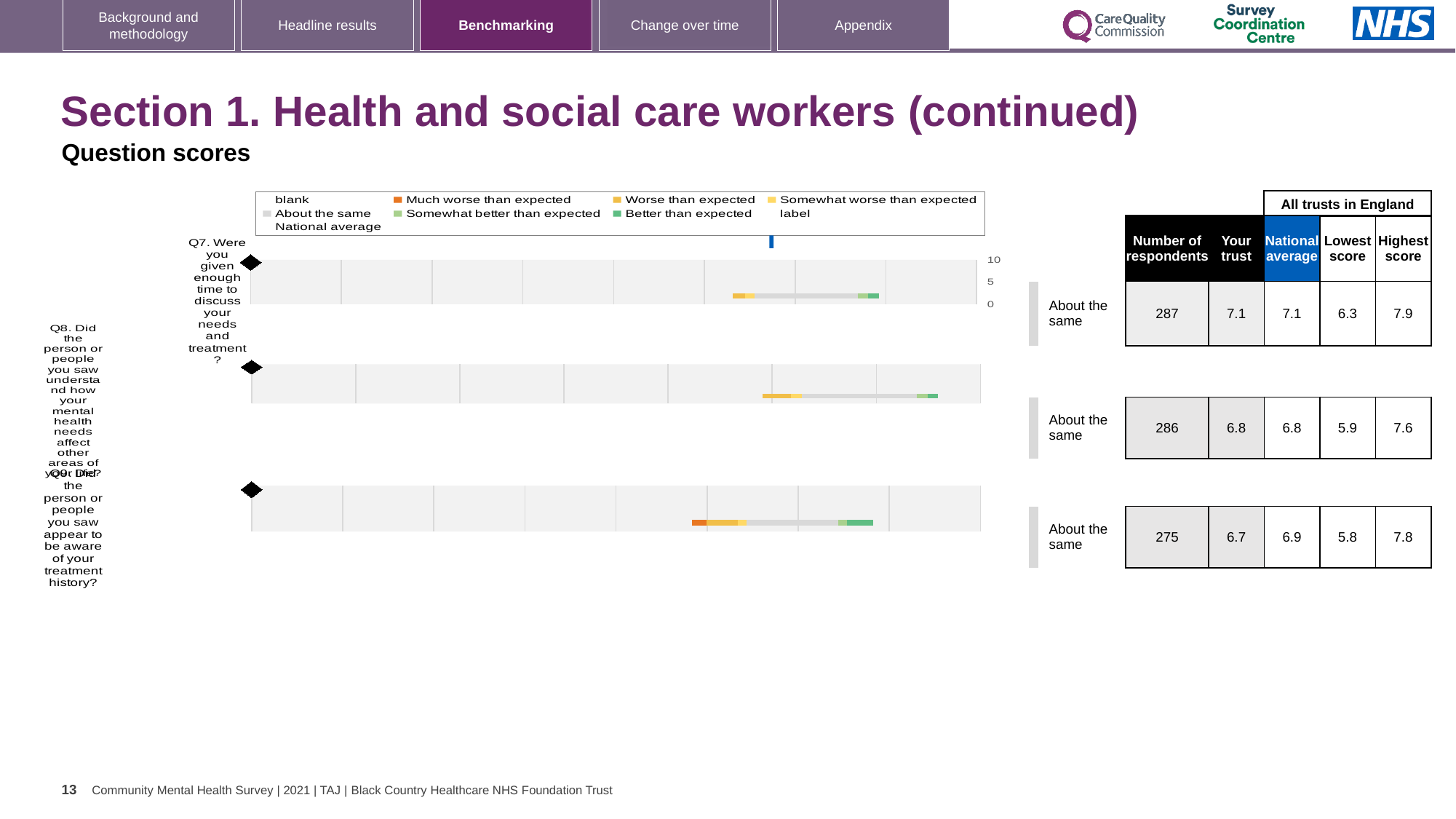
In the table next to the Q9 chart, what is the national average score? 6.9 How many entries does the shared legend above the charts list? 9 In the table next to the Q7 chart, what is the 'Your trust' score? 7.1 What is the highest value shown on the axis of the Q7 chart? 10 What kind of chart is used for the Q7 benchmarking chart on this slide? bar chart In the table next to the Q8 chart, what is the number of respondents? 286 Which question has the higher 'Your trust' score in the tables, Q7 or Q9? Q7 Which of the three questions has the lowest 'Your trust' score in the tables? Q9 What benchmark category label is shown beside the Q8 chart? About the same In the legend above the charts, which colour represents 'Much worse than expected'? orange In the table next to the Q9 chart, what is the difference between the highest score and the lowest score? 2.0 How many benchmarking charts are shown on this slide? 3